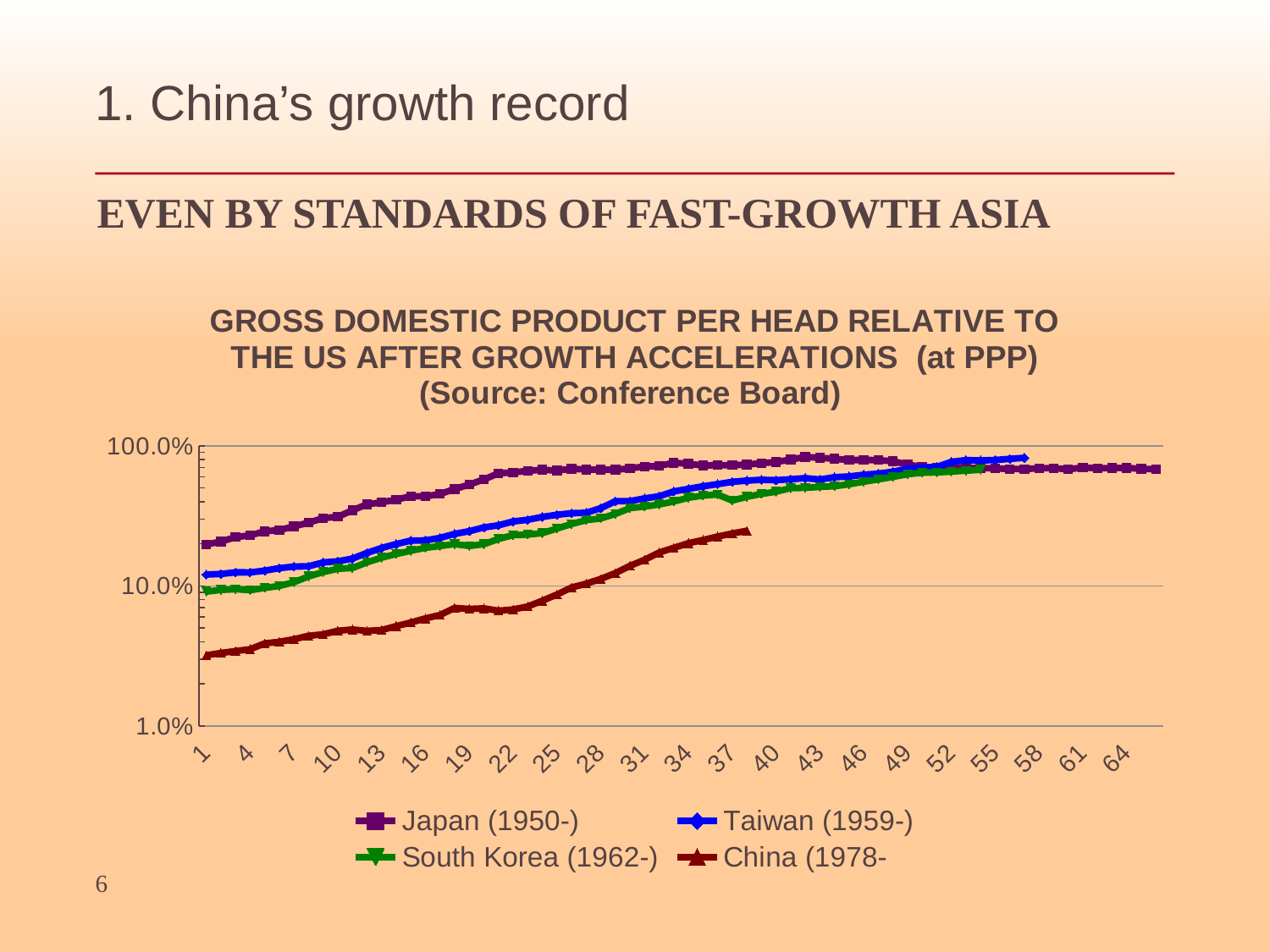
Is the value for China at year 1 greater or less than 10.0%? less Is the value for Japan at year 1 greater or less than 10.0%? greater Which series has the lowest value at year 1 on the x axis? China (1978- Is the value for Japan at year 64 greater or less than 100.0%? less At year 37, which is larger: the value for China or the value for South Korea? South Korea Which series has the highest value at year 1 on the x axis? Japan (1950-) Which series extends furthest along the x axis? Japan (1950-) How many series does the legend list? 4 What source is cited in the chart title? Conference Board What kind of chart is shown on the slide? line chart Does the China line rise or fall as the x axis increases? rise